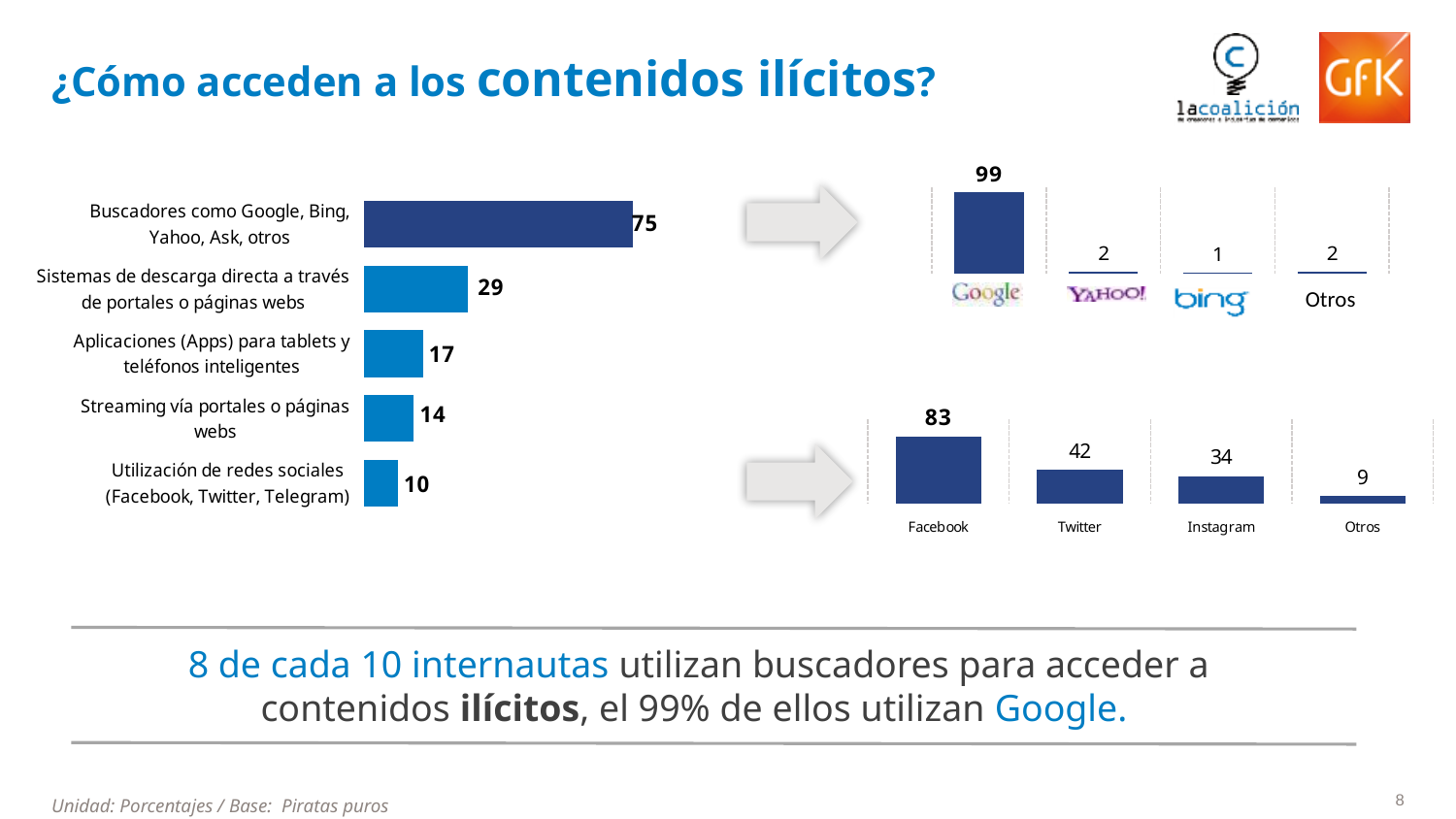
In the top-right chart of search engines, what is the value for Google? 99 In the horizontal bar chart on the left, what is the difference between the values for 'Aplicaciones (Apps) para tablets y teléfonos inteligentes' and 'Streaming vía portales o páginas webs'? 3 In the bottom-right chart of social networks, what is the difference between the values for Facebook and Instagram? 49 In the horizontal bar chart on the left, what is the value for 'Buscadores como Google, Bing, Yahoo, Ask, otros'? 75 In the horizontal bar chart on the left, what is the value for 'Sistemas de descarga directa a través de portales o páginas webs'? 29 In the horizontal bar chart on the left, which category has the lowest value? Utilización de redes sociales (Facebook, Twitter, Telegram) In the bottom-right chart of social networks, what is the value for Twitter? 42 How many categories does the horizontal bar chart on the left show? 5 In the top-right chart of search engines, which search engine has the lowest value? Bing In the bottom-right chart of social networks, which is larger, the value for Instagram or the value for Otros? Instagram In the top-right chart of search engines, what is the difference between the values for Google and Yahoo? 97 What type of chart is the chart on the left of the slide? Bar chart